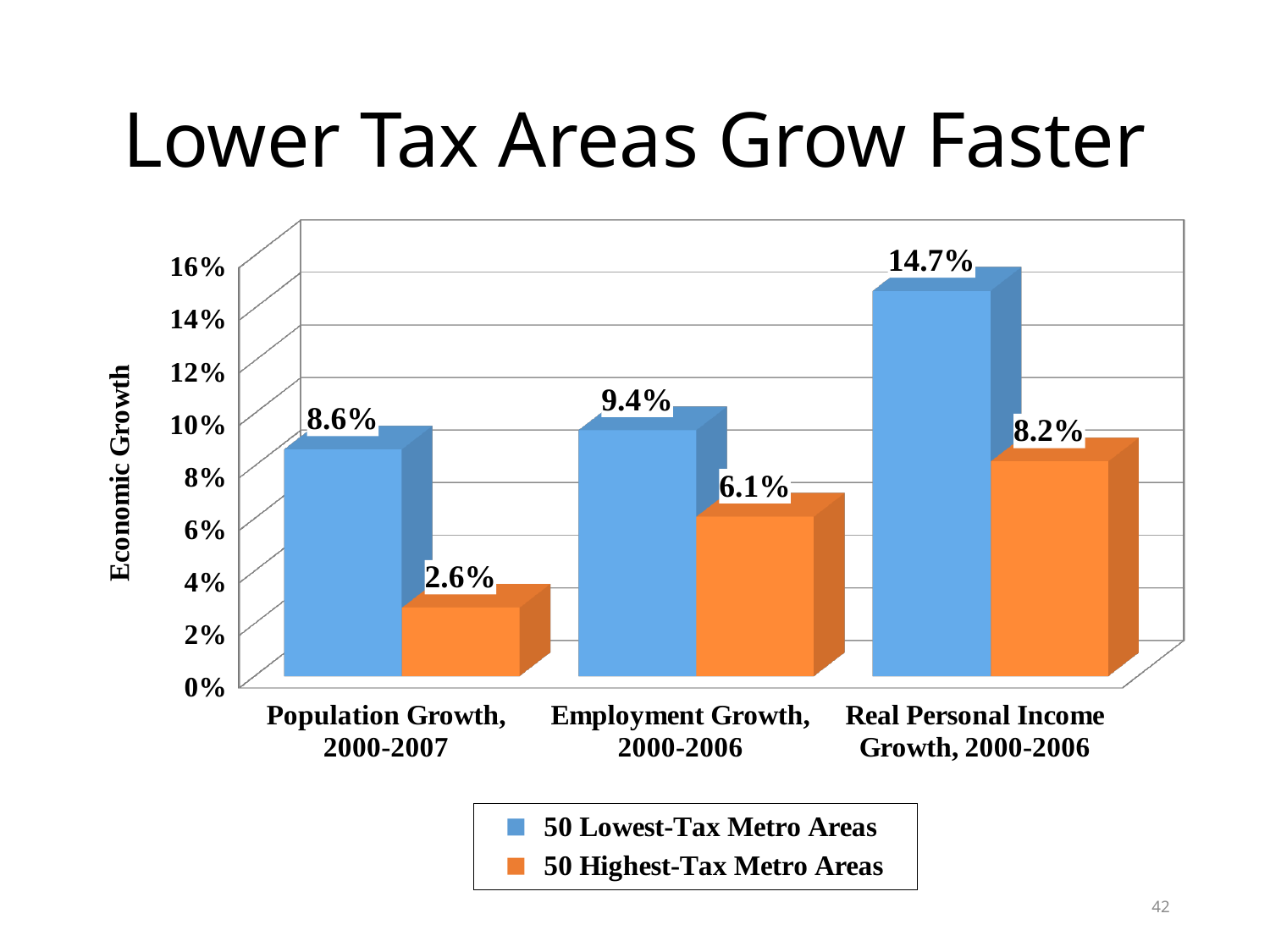
How many categories are shown on the x axis? 3 What is the value for the 50 Lowest-Tax Metro Areas for Population Growth, 2000-2007? 8.6% What kind of chart is shown on the slide? Bar chart How many series does the legend list? 2 What is the value for the 50 Highest-Tax Metro Areas for Real Personal Income Growth, 2000-2006? 8.2% Is the value for the 50 Lowest-Tax Metro Areas for Real Personal Income Growth, 2000-2006 greater or less than 12%? greater What is the difference between the 50 Lowest-Tax and 50 Highest-Tax Metro Areas for Population Growth, 2000-2007? 6.0% What is the difference between the 50 Lowest-Tax and 50 Highest-Tax Metro Areas for Real Personal Income Growth, 2000-2006? 6.5% What is the value for the 50 Highest-Tax Metro Areas for Employment Growth, 2000-2006? 6.1% Which category has the highest value for the 50 Lowest-Tax Metro Areas? Real Personal Income Growth, 2000-2006 Which category has the lowest value for the 50 Highest-Tax Metro Areas? Population Growth, 2000-2007 For Employment Growth, 2000-2006, which series has the larger value? 50 Lowest-Tax Metro Areas